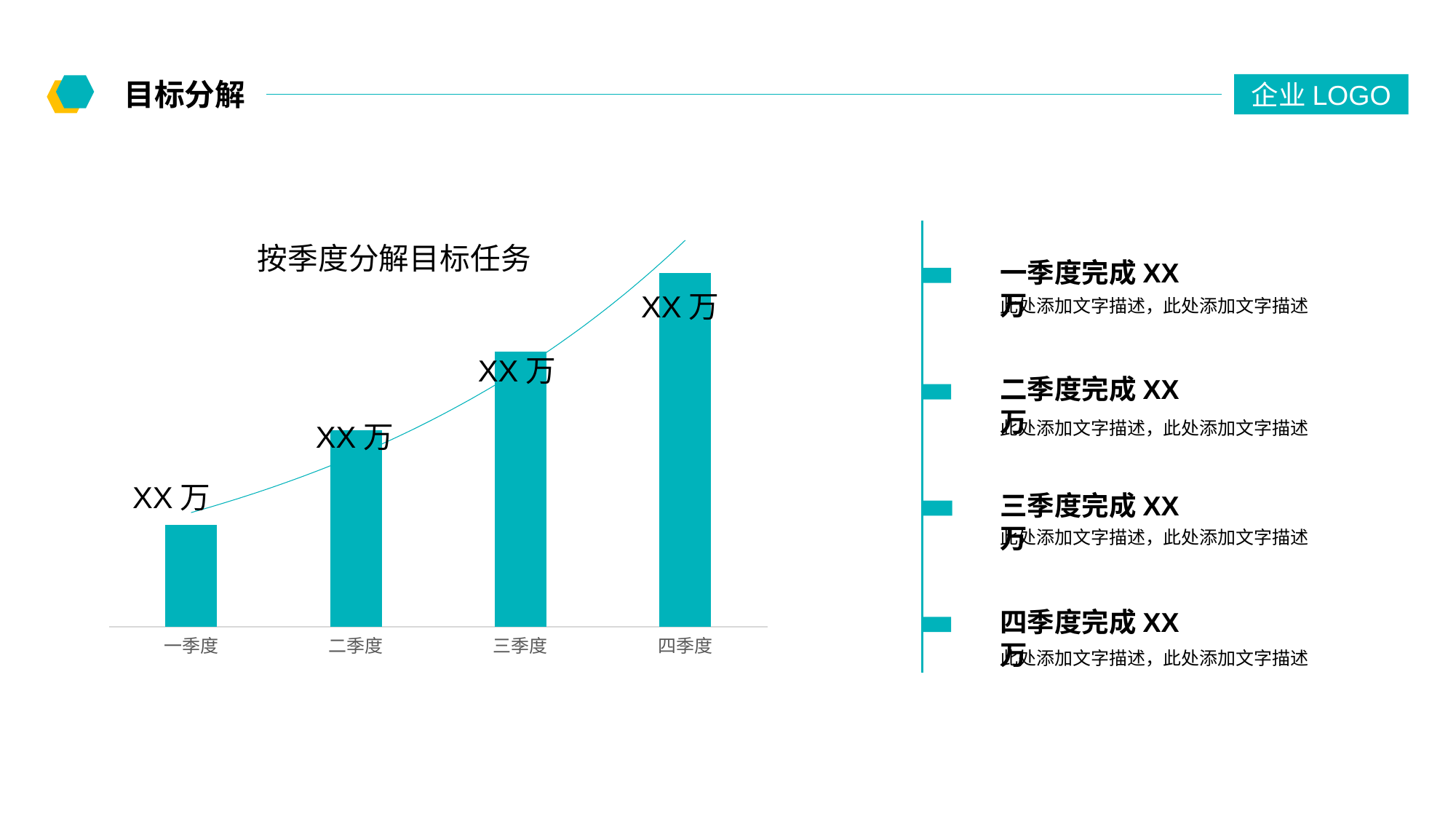
Do the bar values rise or fall from 一季度 to 四季度? rise Which quarter has the tallest bar in the chart? 四季度 Which bar is taller, 一季度 or 四季度? 四季度 Which quarter has the shortest bar in the chart? 一季度 How many categories are plotted on the x axis of the chart? 4 Which bar is taller, 二季度 or 三季度? 三季度 What kind of chart is shown on the slide? bar chart What colour are the bars in the chart? teal What is the title of the chart? 按季度分解目标任务